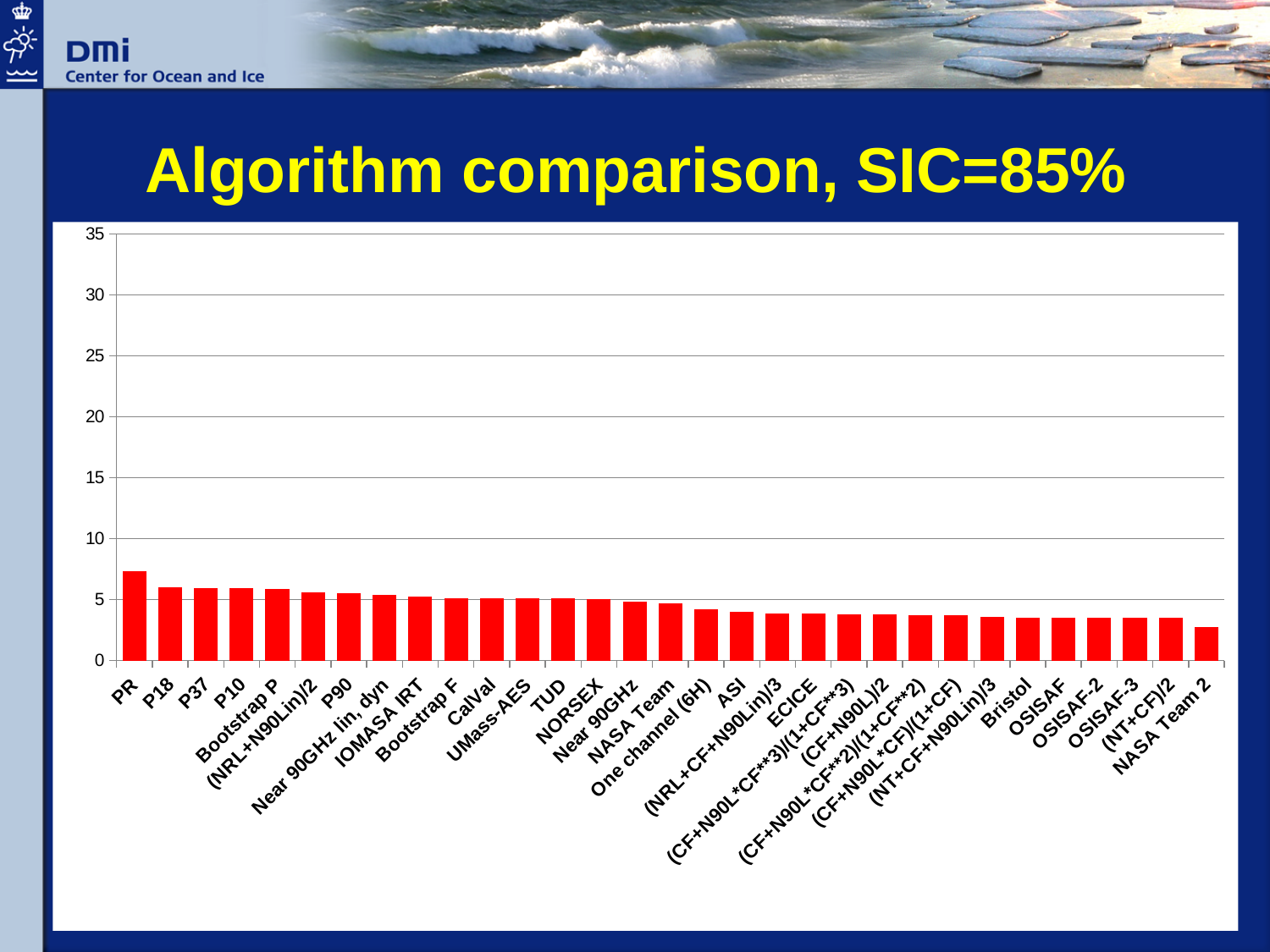
Is the value for PR greater or less than 5? greater Do the bar values generally rise or fall from left to right along the x axis? fall What kind of chart is shown on the slide? bar chart Which has the larger value, P18 or Bristol? P18 Is the value for PR greater or less than 10? less Is the value for NASA Team 2 greater or less than 5? less How many algorithms (bars) are shown in the chart? 31 Which algorithm has the highest bar in the chart? PR Which algorithm has the lowest bar in the chart? NASA Team 2 What is the title of the slide containing the chart? Algorithm comparison, SIC=85% Which has the larger value, PR or NASA Team 2? PR